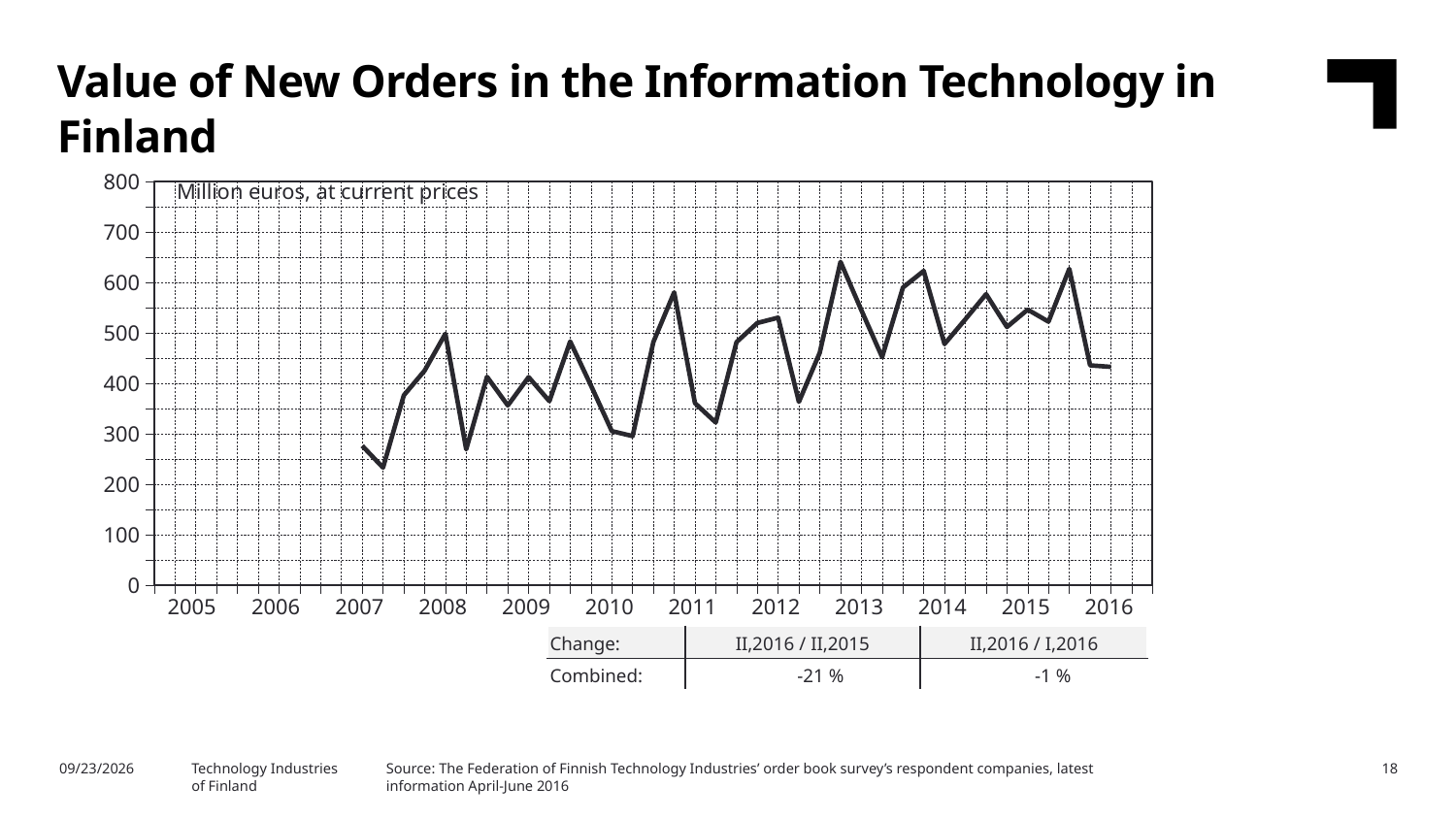
According to the table below the chart, what is the combined change for II,2016 / I,2016? -1 % Is the highest peak of the line, reached around 2013, greater or less than 600? greater How many year labels are shown on the x axis? 12 Is the first plotted value at the start of 2007 greater or less than 300? less In which year does the line reach its lowest point? 2007 What is the title of the chart? Value of New Orders in the Information Technology in Finland Is the last plotted value in 2016 greater or less than 500? less What kind of chart is shown on the slide? line chart What unit is stated in the label inside the chart area? Million euros, at current prices Overall, do the values rise or fall from 2007 to 2016? rise According to the table below the chart, what is the combined change for II,2016 / II,2015? -21 %